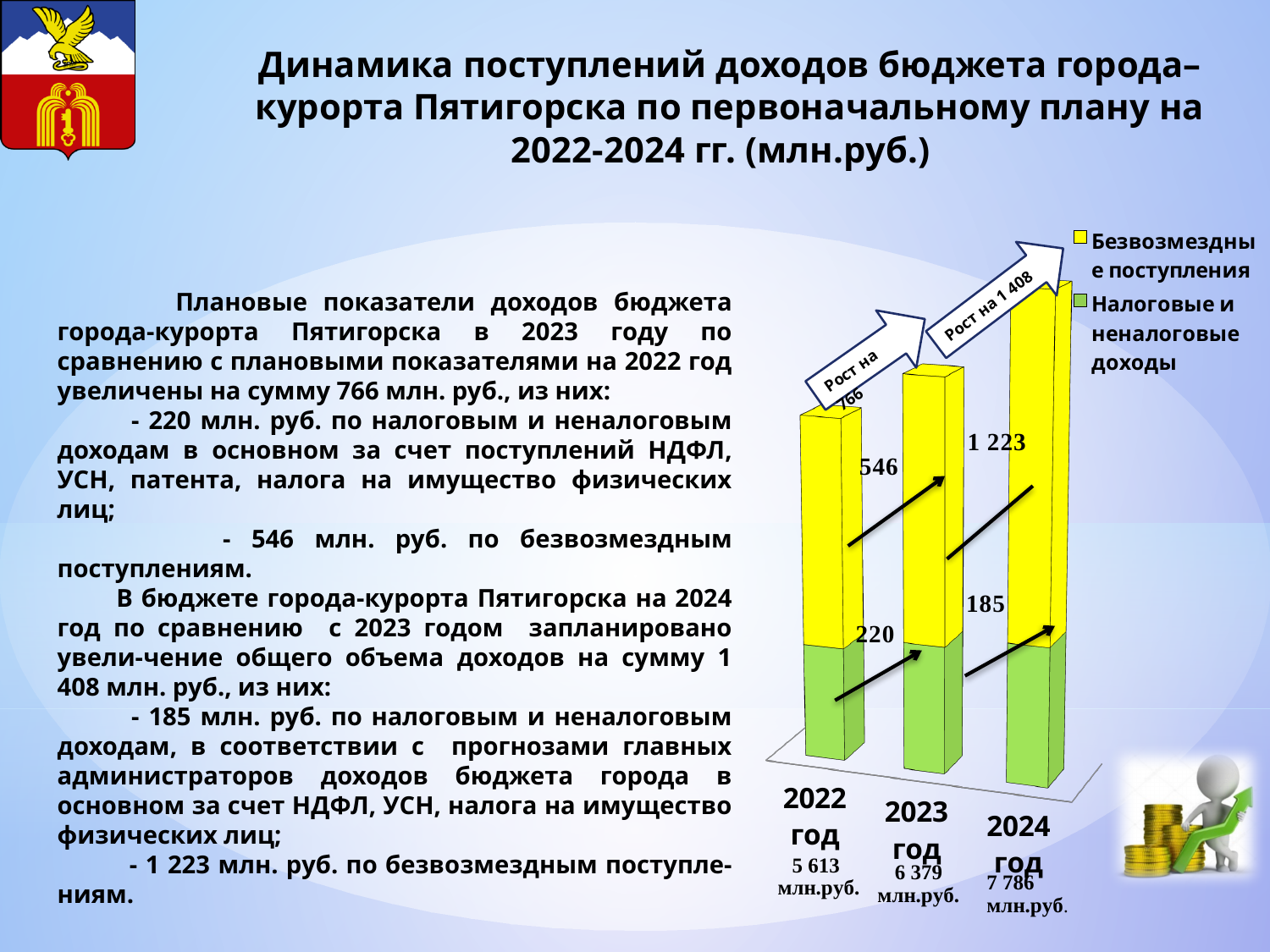
By how much does the total for 2023 год exceed the total for 2022 год? 766 млн.руб. Do the total budget revenues rise or fall from 2022 to 2024? Rise What is the total budget revenue shown for 2023 год? 6 379 млн.руб. What kind of chart is shown on the slide? Stacked bar chart Which year has the highest total budget revenue in the chart? 2024 год Which is larger, the total for 2023 год or the total for 2024 год? 2024 год Which year has the lowest total budget revenue in the chart? 2022 год What is the total budget revenue shown for 2024 год? 7 786 млн.руб. How many years (categories) are plotted in the chart? 3 What is the total budget revenue shown for 2022 год? 5 613 млн.руб. Which series is shown in yellow in the chart legend? Безвозмездные поступления How many series does the chart legend list? 2